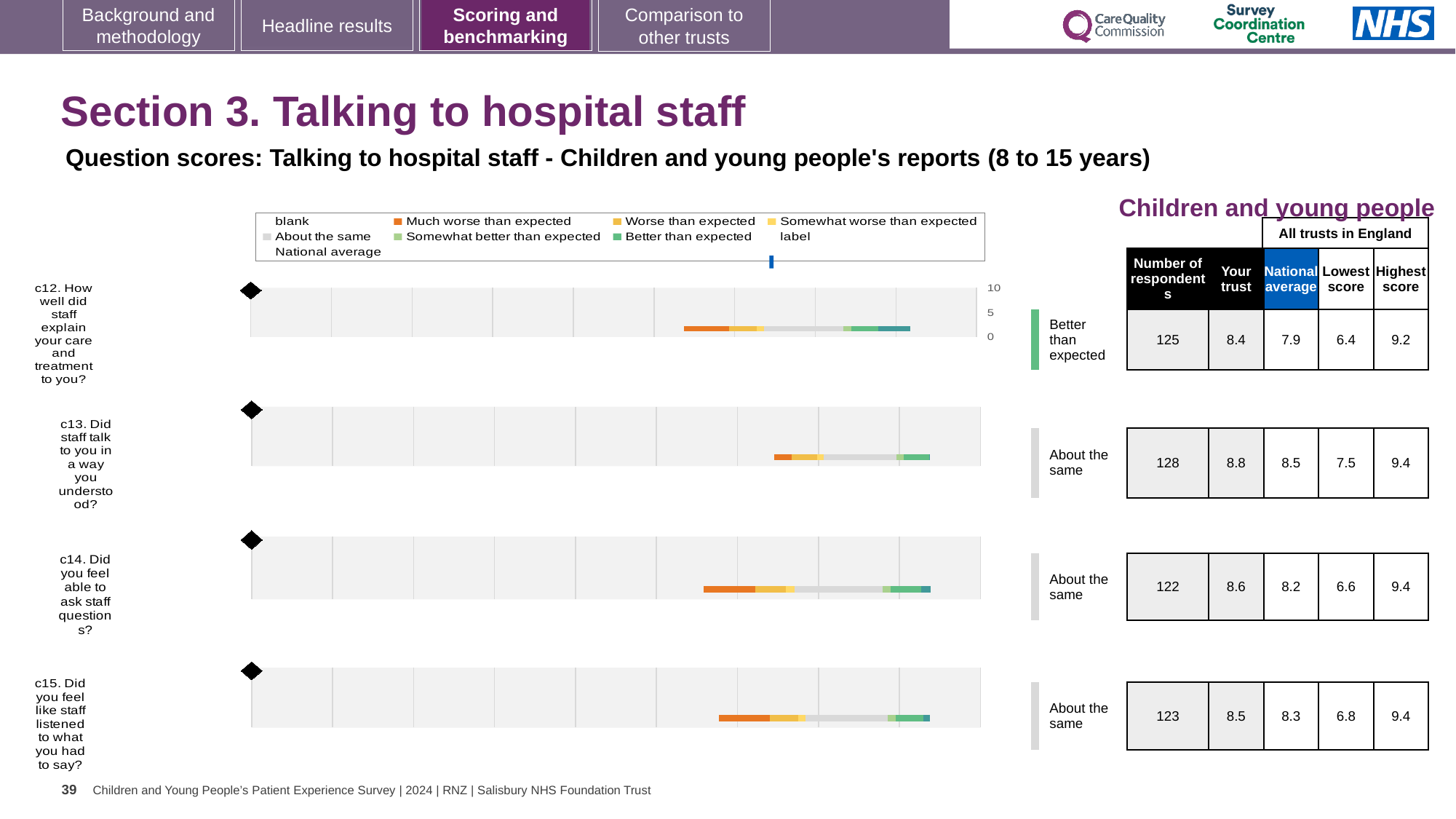
For question c14 (Did you feel able to ask staff questions?), what is the lowest score among all trusts in England? 6.6 How many questions (charts) are shown on the slide? 4 For question c13 (Did staff talk to you in a way you understood?), what is the national average score? 8.5 For question c14, which is larger: the 'Your trust' score or the national average? Your trust Which question has the highest 'Your trust' score? c13. Did staff talk to you in a way you understood? Which question has the lowest 'Your trust' score? c12. How well did staff explain your care and treatment to you? For question c12 (How well did staff explain your care and treatment to you?), what is the 'Your trust' score? 8.4 For question c15 (Did you feel like staff listened to what you had to say?), how many respondents were there? 123 Which question has the fewest respondents? c14. Did you feel able to ask staff questions? For question c12, what is the difference between the 'Your trust' score and the national average? 0.5 What kind of chart is used for each question (c12 to c15) on this slide? bar chart What benchmark category is shown for question c12? Better than expected